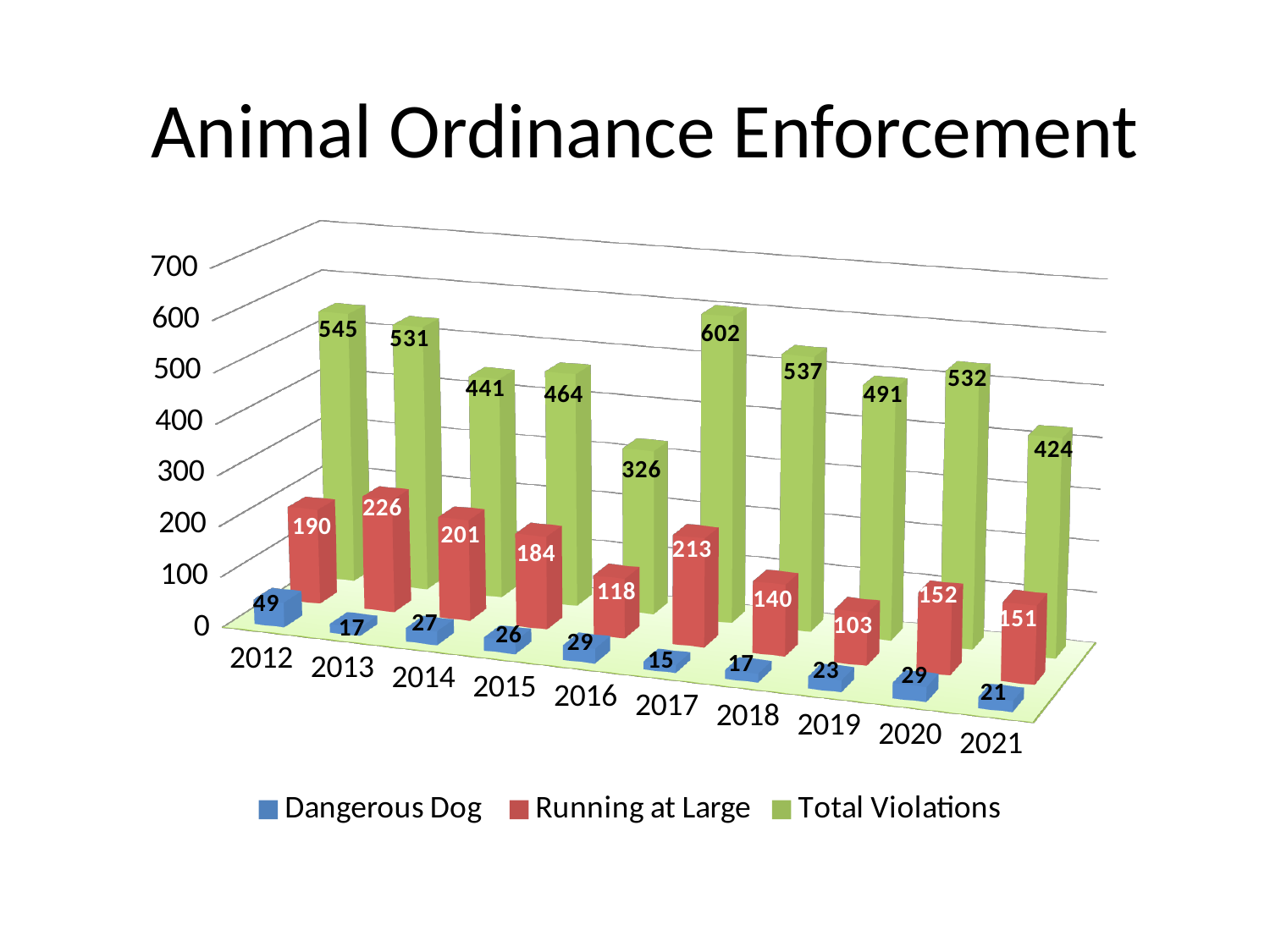
What is the title of the chart? Animal Ordinance Enforcement What is the value for Running at Large in 2013? 226 What kind of chart is shown on the slide? bar chart Which year has the highest Total Violations? 2017 How many series does the legend list? 3 Which year has the lowest Running at Large value? 2019 What is the value for Total Violations in 2017? 602 Which is larger, Running at Large in 2020 or in 2021? 2020 How many years are shown on the x axis? 10 What is the difference between Total Violations in 2017 and 2016? 276 What is the value for Dangerous Dog in 2012? 49 Which year has the lowest Total Violations? 2016